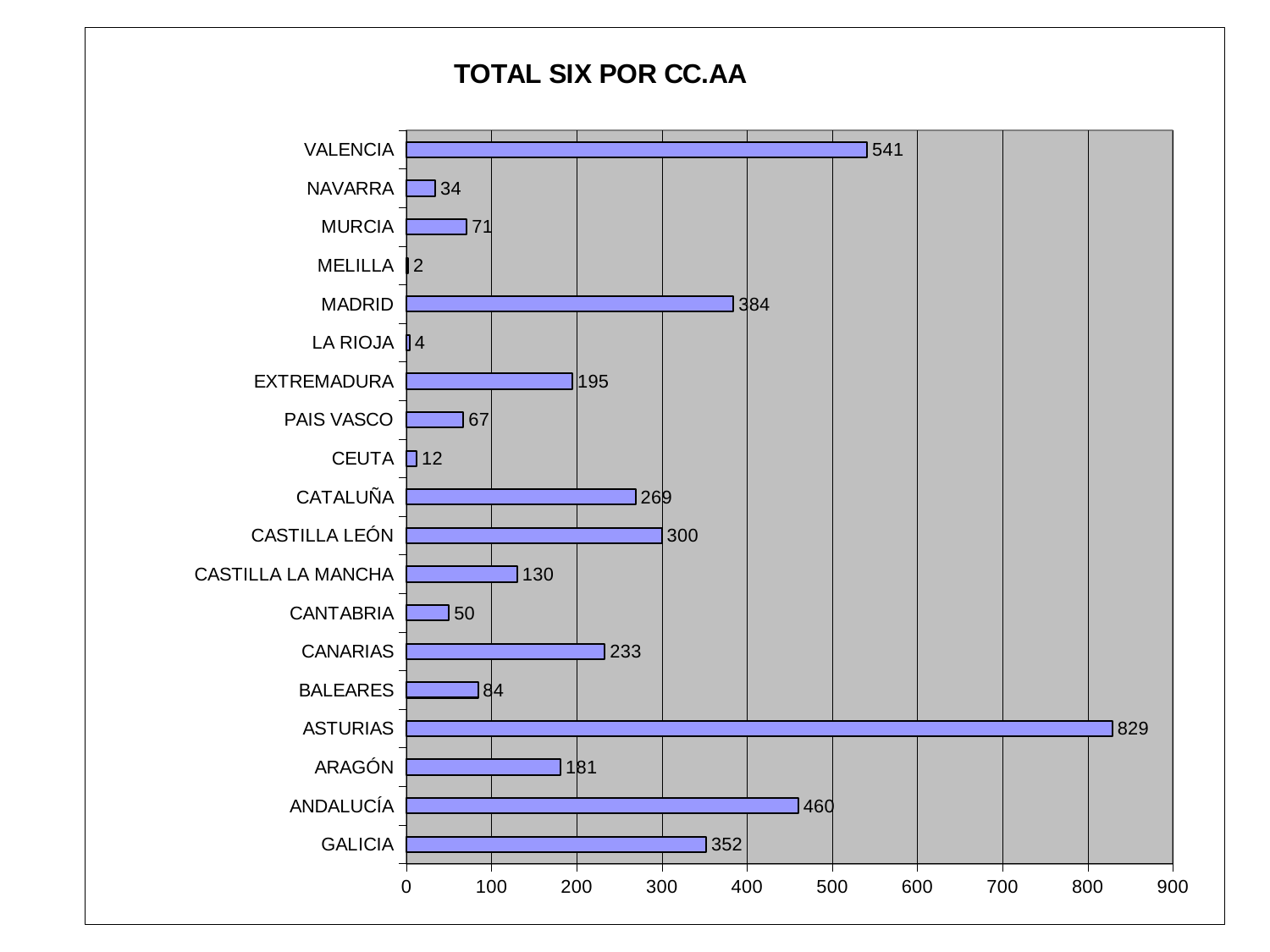
What is the highest value shown on the horizontal axis? 900 Which category has the lowest value? MELILLA What is the title of the chart? TOTAL SIX POR CC.AA Which is larger, the value for MADRID or the value for GALICIA? MADRID Which category has the highest value? ASTURIAS Is the value for CATALUÑA greater or less than 300? less What is the value for ASTURIAS? 829 What kind of chart is this? bar chart What is the value for CASTILLA LA MANCHA? 130 What is the value for MELILLA? 2 How many categories are shown in the chart? 19 What is the difference between the values for VALENCIA and ANDALUCÍA? 81